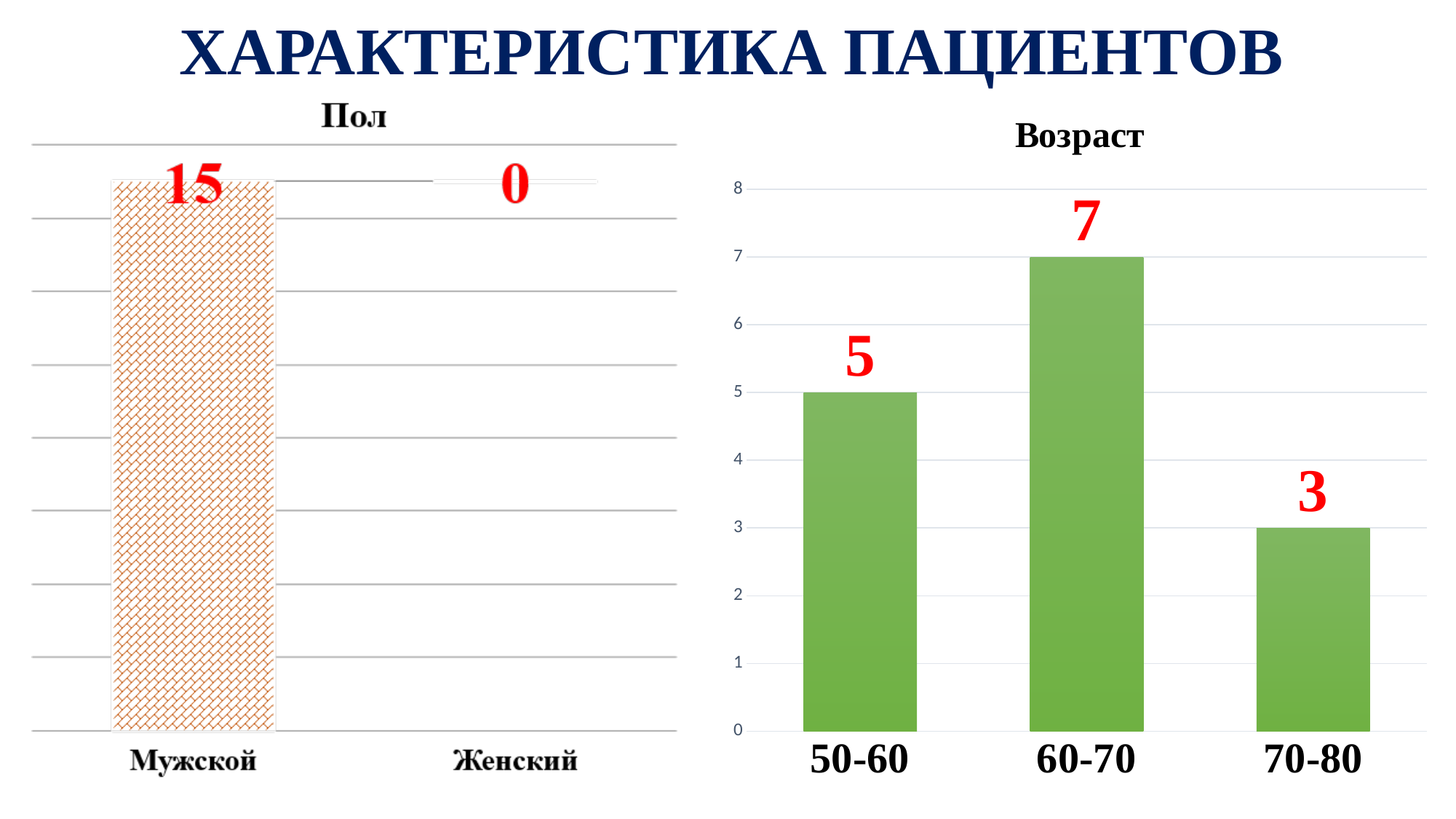
In the "Пол" chart, how many categories are shown on the x axis? 2 In the "Возраст" chart, what is the value for 70-80? 3 In the "Возраст" chart, which is larger, the value for 50-60 or the value for 70-80? 50-60 In the "Пол" chart, what is the value for Мужской? 15 In the "Возраст" chart, which age group has the highest value? 60-70 In the "Возраст" chart, which age group has the lowest value? 70-80 In the "Возраст" chart, what is the value for 60-70? 7 In the "Пол" chart, what is the difference between the values for Мужской and Женский? 15 In the "Возраст" chart, what is the difference between the values for 60-70 and 50-60? 2 In the "Пол" chart, what is the value for Женский? 0 In the "Возраст" chart, how many age groups are shown? 3 What kind of chart is the "Возраст" chart? Bar chart